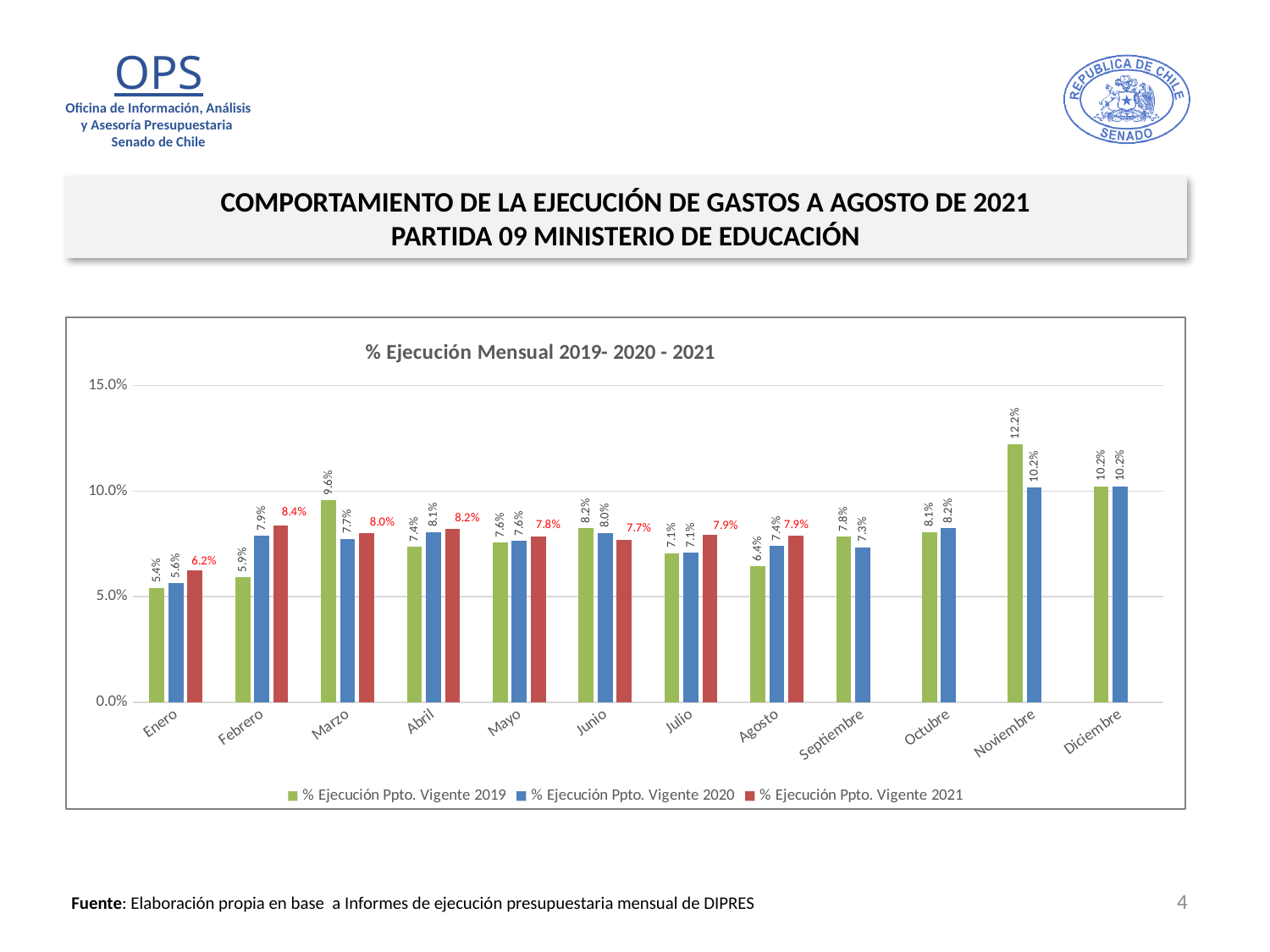
Is the value for % Ejecución Ppto. Vigente 2019 in Noviembre greater or less than 10.0%? greater What is the value for % Ejecución Ppto. Vigente 2019 in Marzo? 9.6% Which month has the highest value for % Ejecución Ppto. Vigente 2019? Noviembre What kind of chart is shown? Bar chart Which is larger in Febrero: the 2019 value or the 2021 value? 2021 value (8.4%) How many series does the legend list? 3 What is the title of the chart? % Ejecución Mensual 2019- 2020 - 2021 How many months are shown on the x axis? 12 What is the value for % Ejecución Ppto. Vigente 2021 in Enero? 6.2% Which month has the lowest value for % Ejecución Ppto. Vigente 2020? Enero What is the difference between the 2019 and 2020 values in Noviembre? 2.0% What is the value for % Ejecución Ppto. Vigente 2020 in Agosto? 7.4%